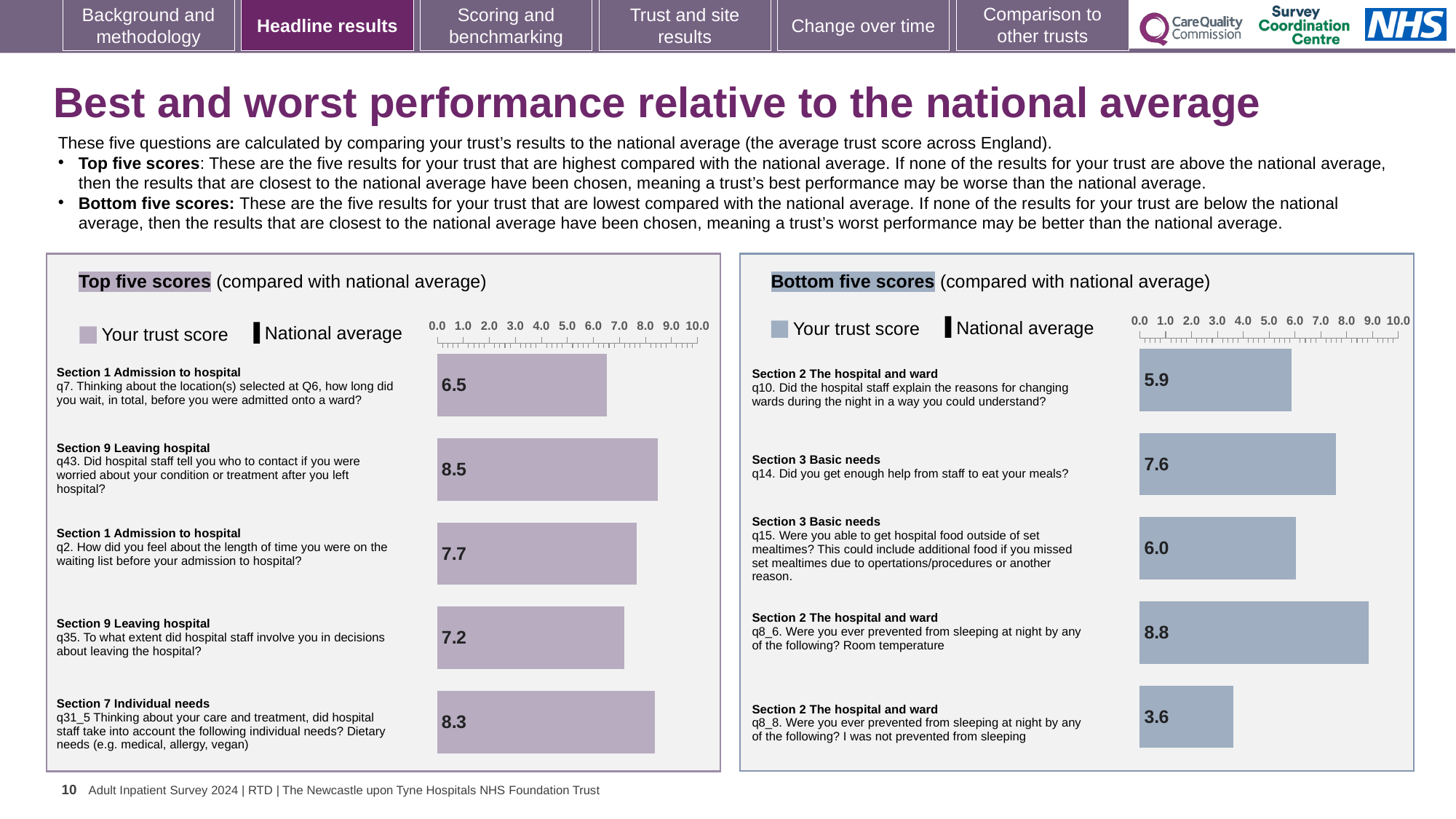
In the Bottom five scores chart, which question has the lowest trust score? q8_8 In the Bottom five scores chart, what is the trust score for q14 (Did you get enough help from staff to eat your meals)? 7.6 In the Top five scores chart, what is the trust score for q7 (how long did you wait before being admitted onto a ward)? 6.5 How many questions are plotted in the Bottom five scores chart? 5 In the Top five scores chart, what is the trust score for q43 (Did hospital staff tell you who to contact if you were worried about your condition or treatment after you left hospital)? 8.5 What kind of chart is the Top five scores chart? Bar chart In the Top five scores chart, which question has the highest trust score? q43 In the Bottom five scores chart, what is the trust score for q8_8 (I was not prevented from sleeping)? 3.6 In the Bottom five scores chart, which question has the highest trust score? q8_6 In the Top five scores chart, what is the difference between the trust scores for q43 and q7? 2.0 In the Bottom five scores chart, what is the difference between the trust scores for q8_6 and q8_8? 5.2 In the Top five scores chart, which has the larger trust score, q2 or q35? q2